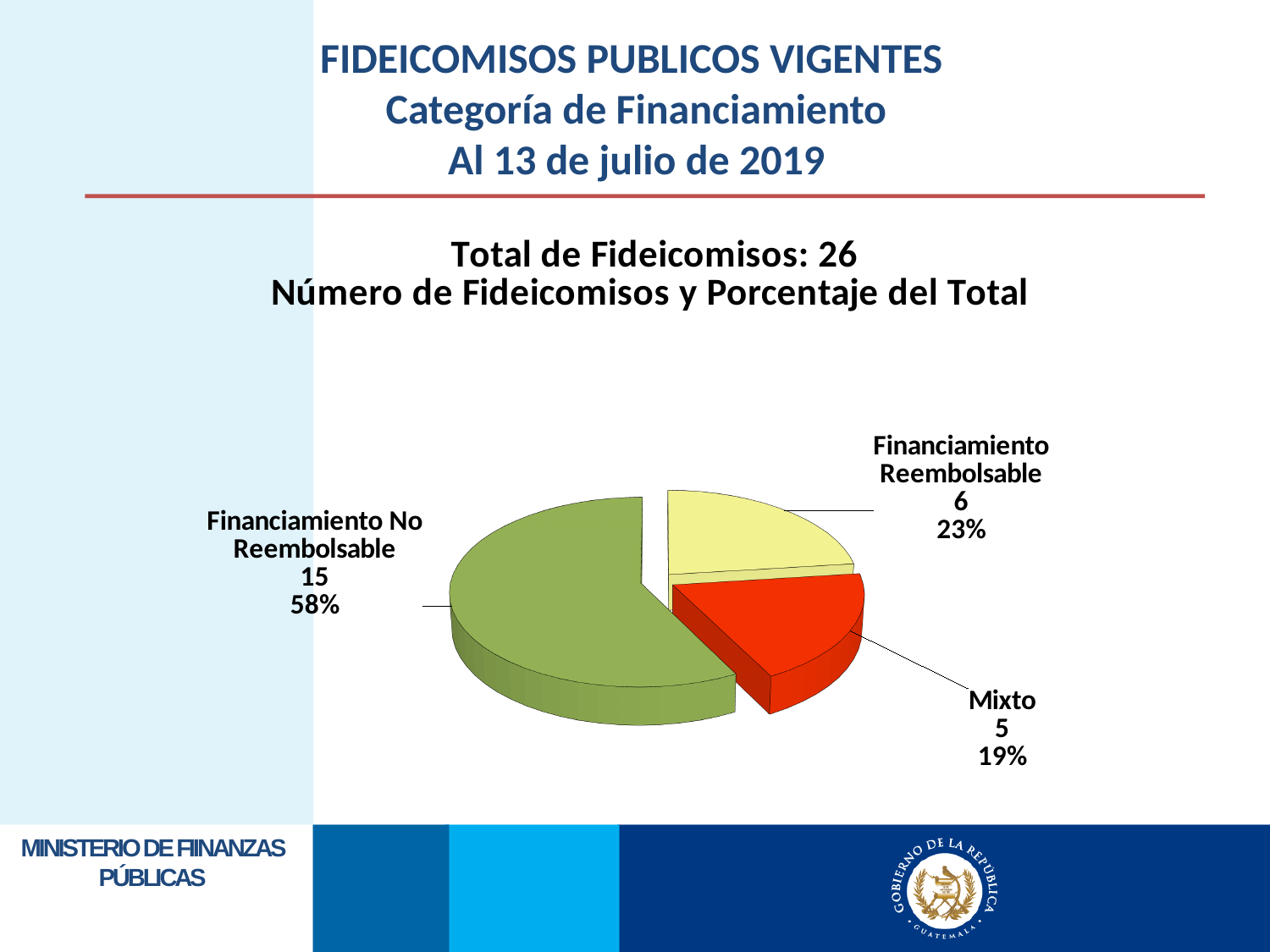
How many more fideicomisos are in Financiamiento No Reembolsable than in Financiamiento Reembolsable? 9 How many fideicomisos are in the Financiamiento No Reembolsable category? 15 Which category has the largest number of fideicomisos? Financiamiento No Reembolsable What is the total number of fideicomisos stated on the slide? 26 How many fideicomisos are in the Mixto category? 5 What kind of chart is shown on the slide? pie chart How many categories does the pie chart show? 3 Which has more fideicomisos, Financiamiento Reembolsable or Mixto? Financiamiento Reembolsable What percentage of the total does Financiamiento Reembolsable represent? 23% What share of the pie does Mixto account for? 19% Which category has the smallest number of fideicomisos? Mixto What colour is the Mixto slice of the pie? red